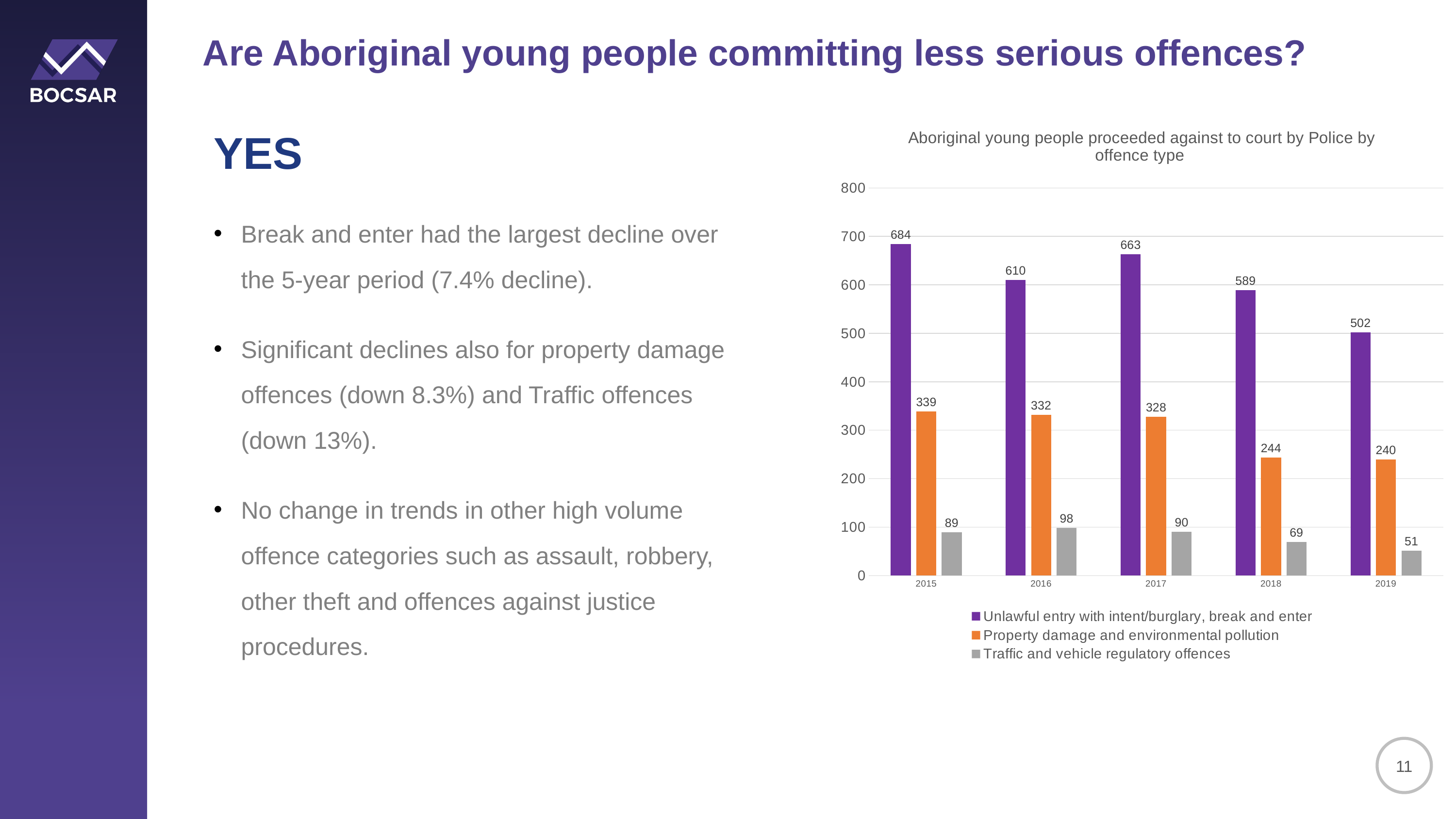
What kind of chart is shown on the slide? Bar chart In which year is the value for Unlawful entry with intent/burglary, break and enter lowest? 2019 What is the value for Unlawful entry with intent/burglary, break and enter in 2015? 684 How many series does the legend list? 3 How many years are shown on the x axis? 5 What is the value for Traffic and vehicle regulatory offences in 2016? 98 What is the difference between the Unlawful entry with intent/burglary, break and enter values for 2015 and 2019? 182 Is the value for Unlawful entry with intent/burglary, break and enter in 2018 greater or less than 500? greater What is the value for Property damage and environmental pollution in 2018? 244 In which year is the value for Traffic and vehicle regulatory offences highest? 2016 Does the value for Traffic and vehicle regulatory offences rise or fall from 2017 to 2019? Fall Which is larger: Property damage and environmental pollution in 2016 or in 2017? 2016